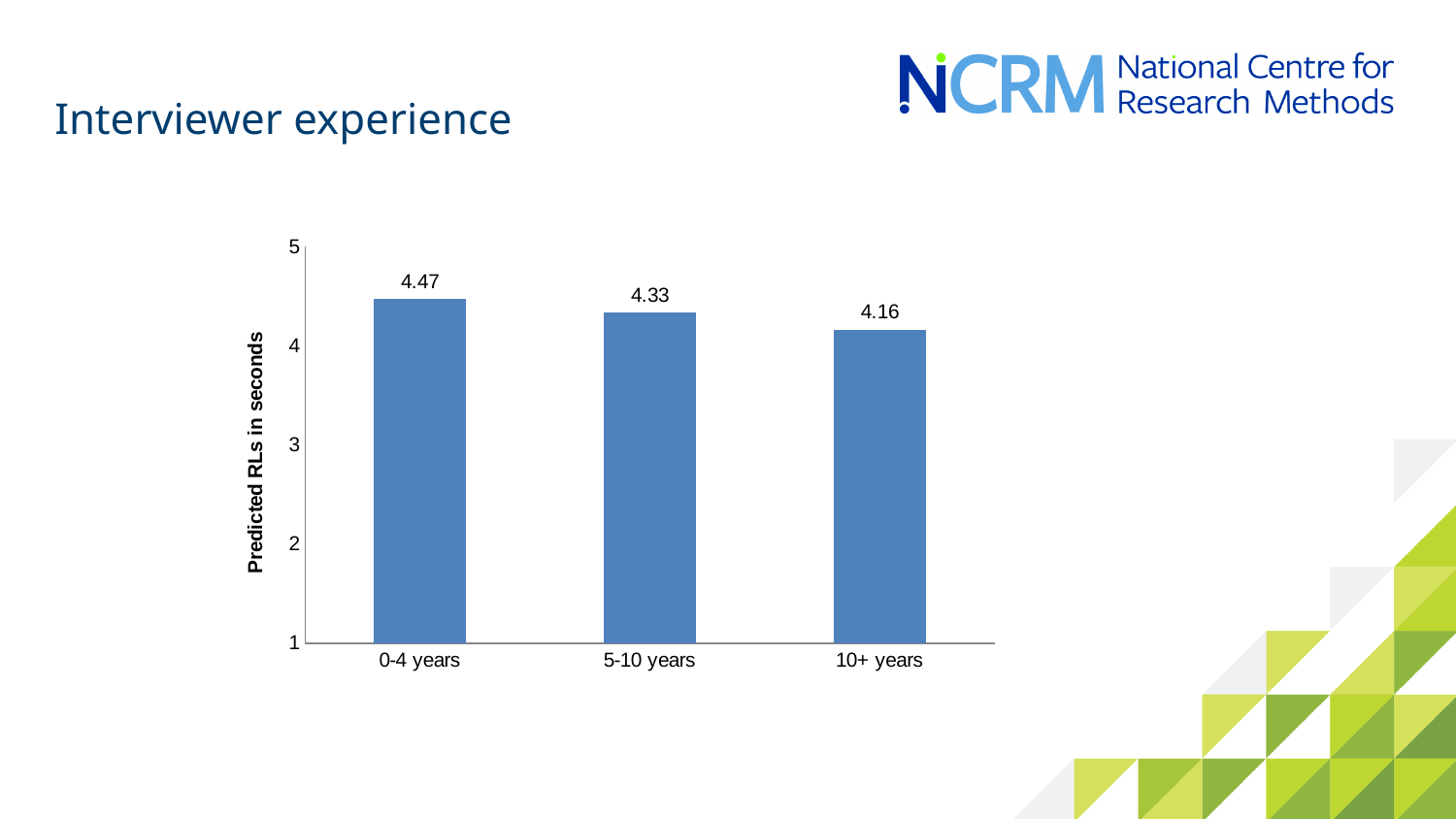
What is the predicted RL in seconds for interviewers with 5-10 years of experience? 4.33 What is the difference in predicted RLs between the 0-4 years and 10+ years groups? 0.31 What is the difference in predicted RLs between the 0-4 years and 5-10 years groups? 0.14 What kind of chart is shown on the slide? Bar chart Which experience group has the highest predicted RL? 0-4 years Do the predicted RLs rise or fall as interviewer experience increases along the x axis? Fall What is the predicted RL in seconds for interviewers with 0-4 years of experience? 4.47 Which experience group has the lowest predicted RL? 10+ years Which has a larger predicted RL, 5-10 years or 10+ years? 5-10 years What is the predicted RL in seconds for interviewers with 10+ years of experience? 4.16 How many experience categories are shown on the chart? 3 Is the value for 10+ years greater or less than 4? greater